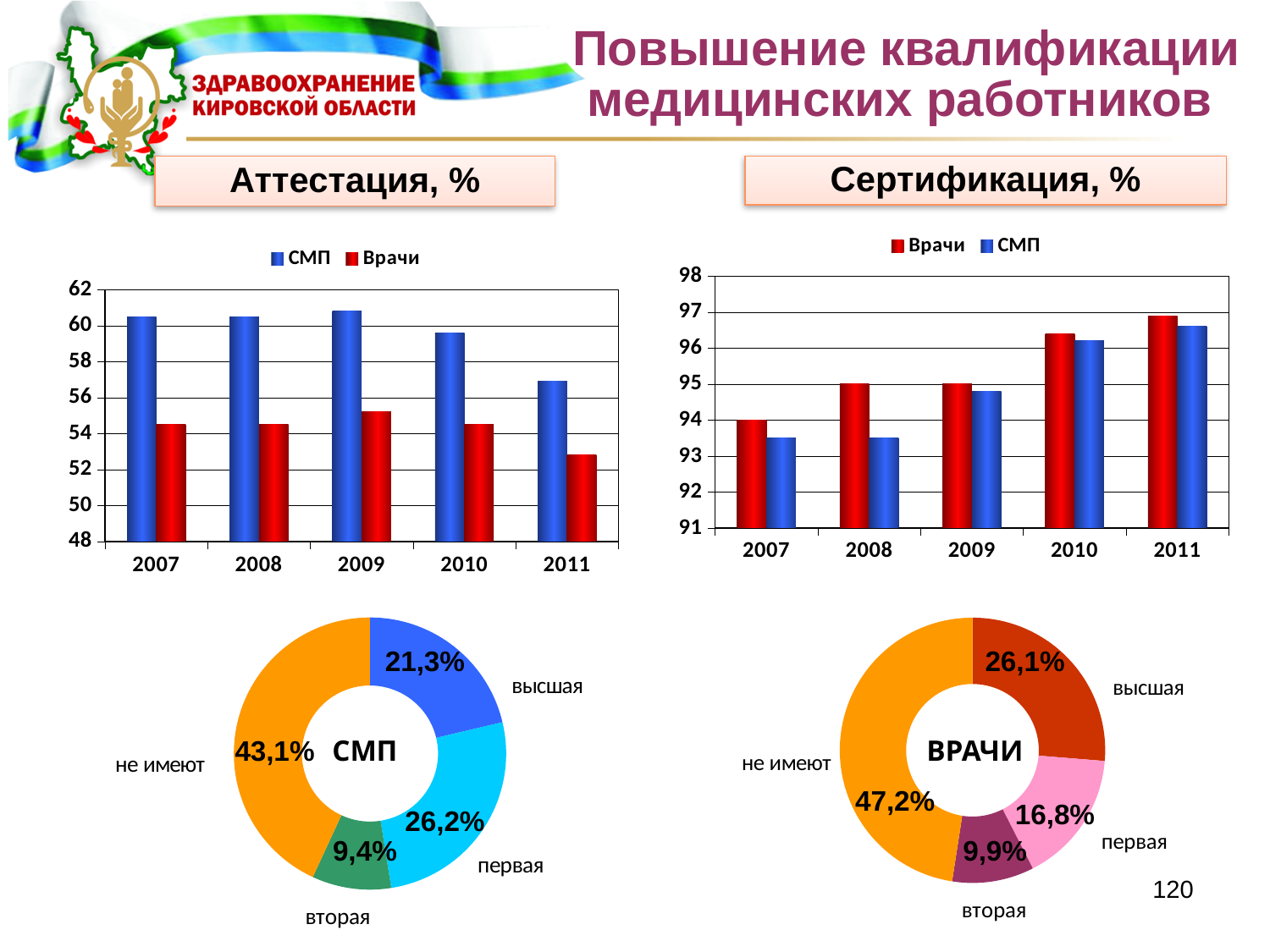
In the Аттестация, % chart, is the value for Врачи in 2011 greater or less than 54? less In the Аттестация, % chart, how many series does the legend list? 2 In the Сертификация, % chart, which year has the highest value for Врачи? 2011 In the СМП doughnut chart at the bottom left, what is the difference between первая and вторая? 16,8% In the ВРАЧИ doughnut chart at the bottom right, what is the value for высшая? 26,1% In the Аттестация, % chart, is the value for СМП in 2011 greater or less than 58? less In the Сертификация, % chart, do the values for Врачи rise or fall from 2007 to 2011? rise In the Аттестация, % chart, how many years are shown on the x axis? 5 In the Аттестация, % chart, which is larger in 2009, СМП or Врачи? СМП In the СМП doughnut chart at the bottom left, what share is labelled не имеют? 43,1% In the Сертификация, % chart, is the value for Врачи in 2007 greater or less than 95? less What kind of chart is the Аттестация, % chart at the top left? bar chart